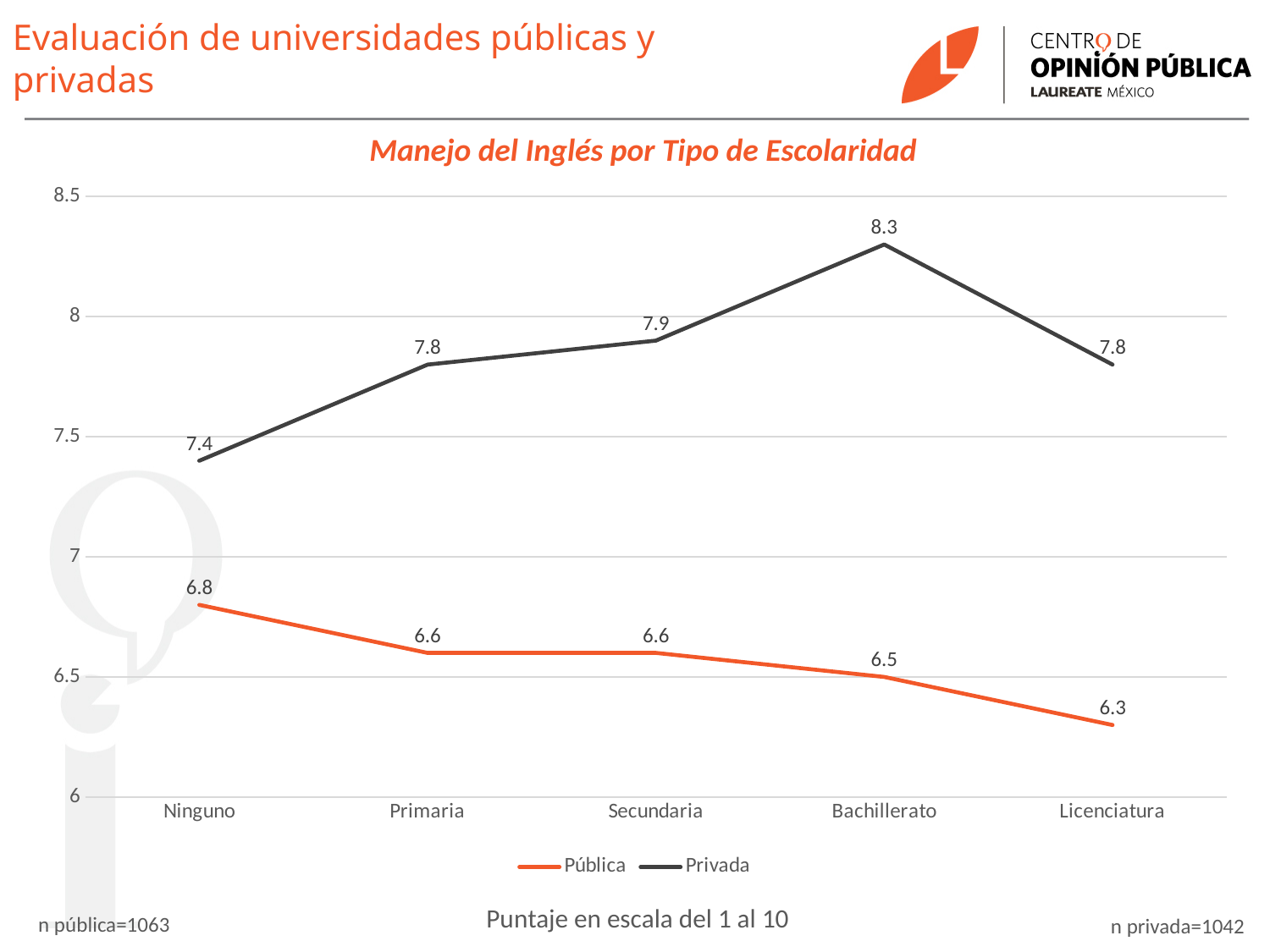
Is the value for Pública at Ninguno greater or less than 7? less Which category has the highest value for the Privada series? Bachillerato Which is larger at Secundaria, the Pública value or the Privada value? Privada What is the difference between Privada and Pública at Bachillerato? 1.8 What is the value for Privada at Bachillerato? 8.3 Does the Pública series rise or fall from Ninguno to Licenciatura? fall What kind of chart is shown? line chart What is the value for Pública at Licenciatura? 6.3 Which category has the lowest value for the Pública series? Licenciatura What is the value for Privada at Ninguno? 7.4 How many series does the legend list? 2 How many categories are shown on the x axis? 5